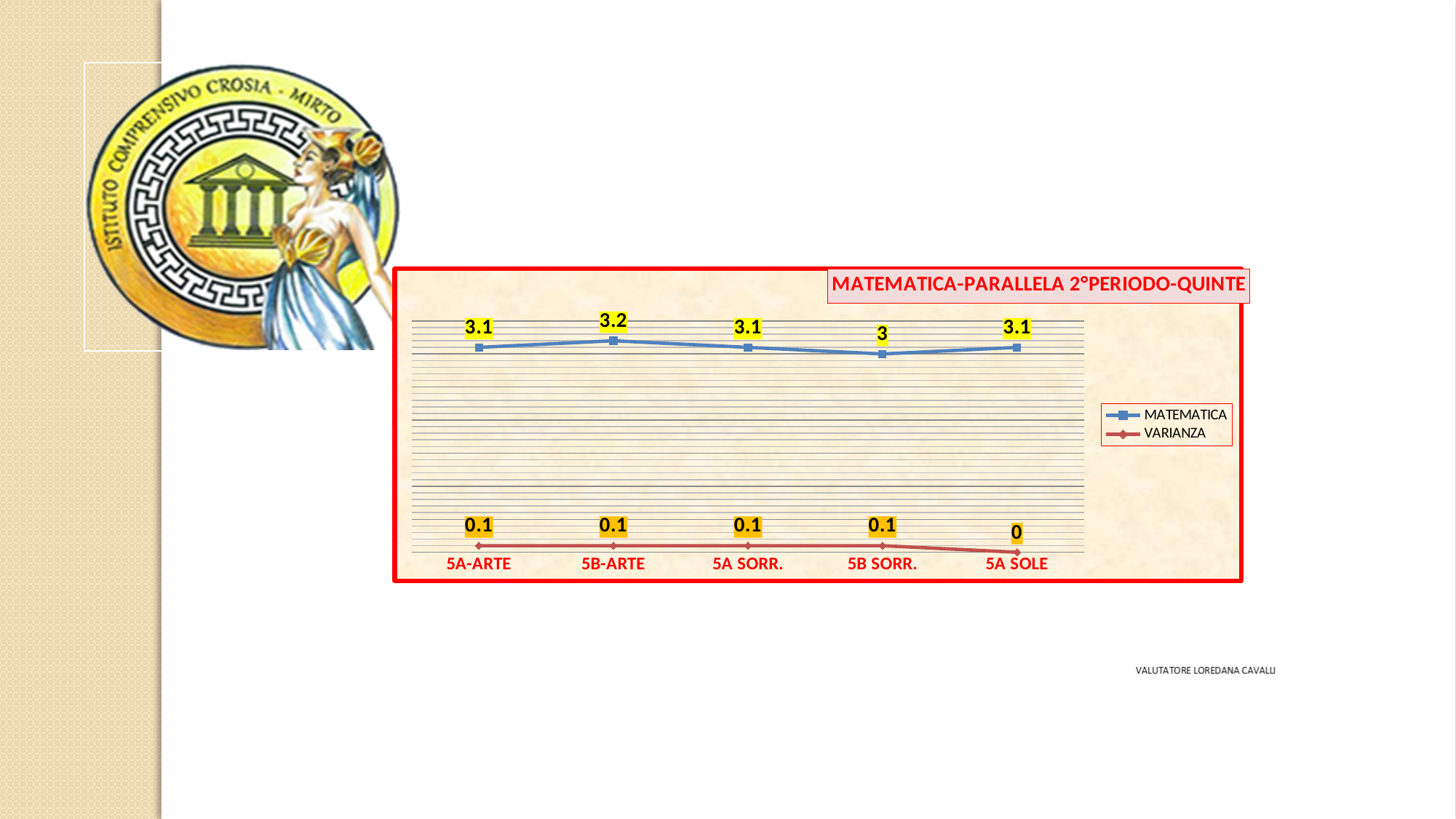
Which is larger, the MATEMATICA value for 5A-ARTE or for 5B SORR.? 5A-ARTE How many categories are shown on the x axis? 5 What is the difference between the MATEMATICA values for 5B-ARTE and 5B SORR.? 0.2 What is the VARIANZA value for 5A SOLE? 0 What is the MATEMATICA value for 5B SORR.? 3 Which category has the lowest MATEMATICA value? 5B SORR. Which category has the highest MATEMATICA value? 5B-ARTE Which category has the lowest VARIANZA value? 5A SOLE What kind of chart is shown on the slide? Line chart What is the VARIANZA value for 5A-ARTE? 0.1 How many series does the legend list? 2 What is the MATEMATICA value for 5B-ARTE? 3.2